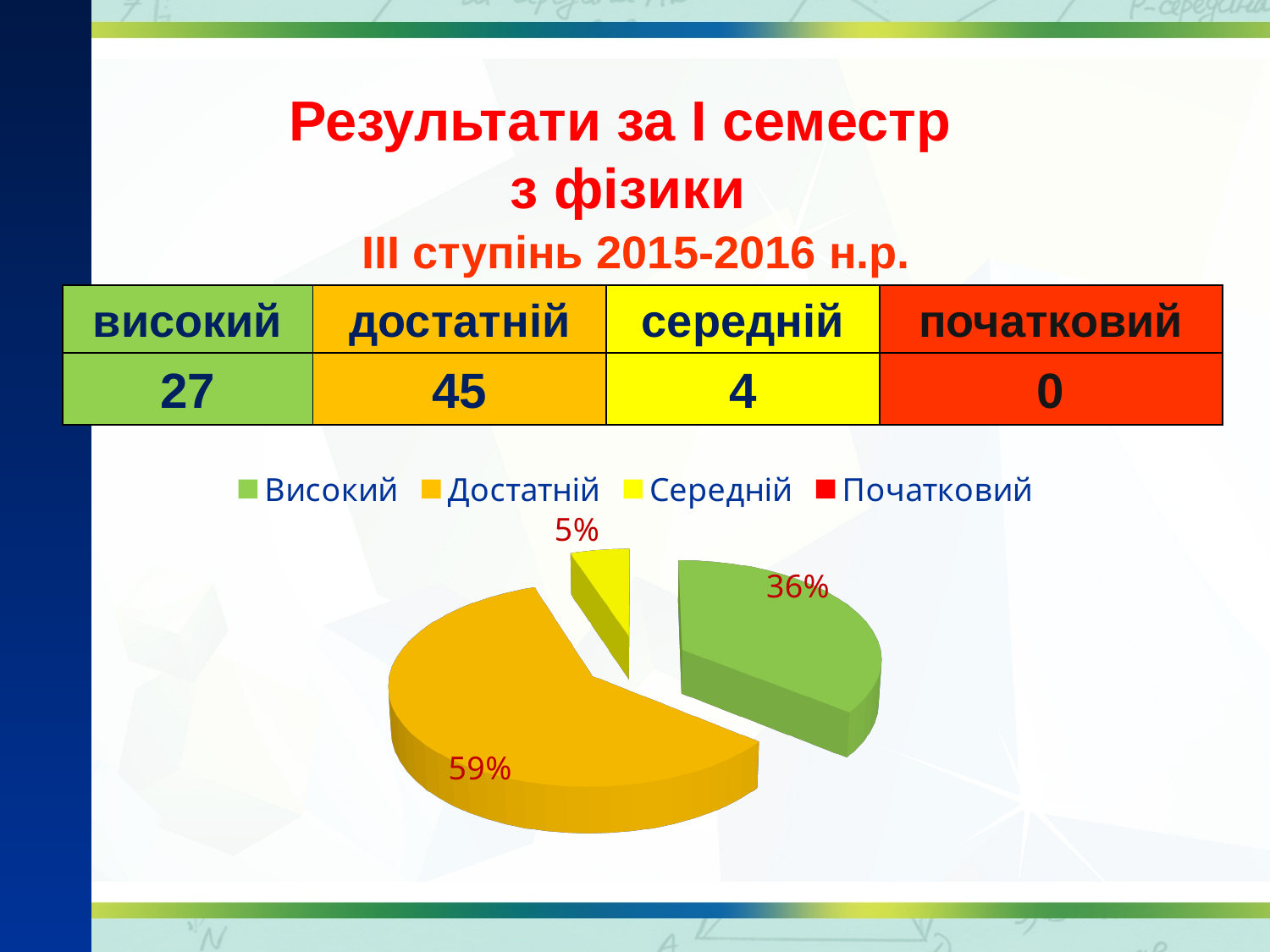
What percentage does the pie chart show for Високий? 36% Which slice is larger in the pie chart, Високий or Середній? Високий What percentage does the pie chart show for Достатній? 59% What colour is the Достатній slice in the pie chart? orange What percentage does the pie chart show for Середній? 5% By how many percentage points does the Достатній slice exceed the Високий slice? 23 Which category has the largest slice in the pie chart? Достатній How many entries does the legend of the pie chart list? 4 Which labelled slice of the pie chart is the smallest? Середній What kind of chart is shown on the slide? pie chart What is the combined share of the Високий and Середній slices? 41% How many slices in the pie chart have a percentage label? 3